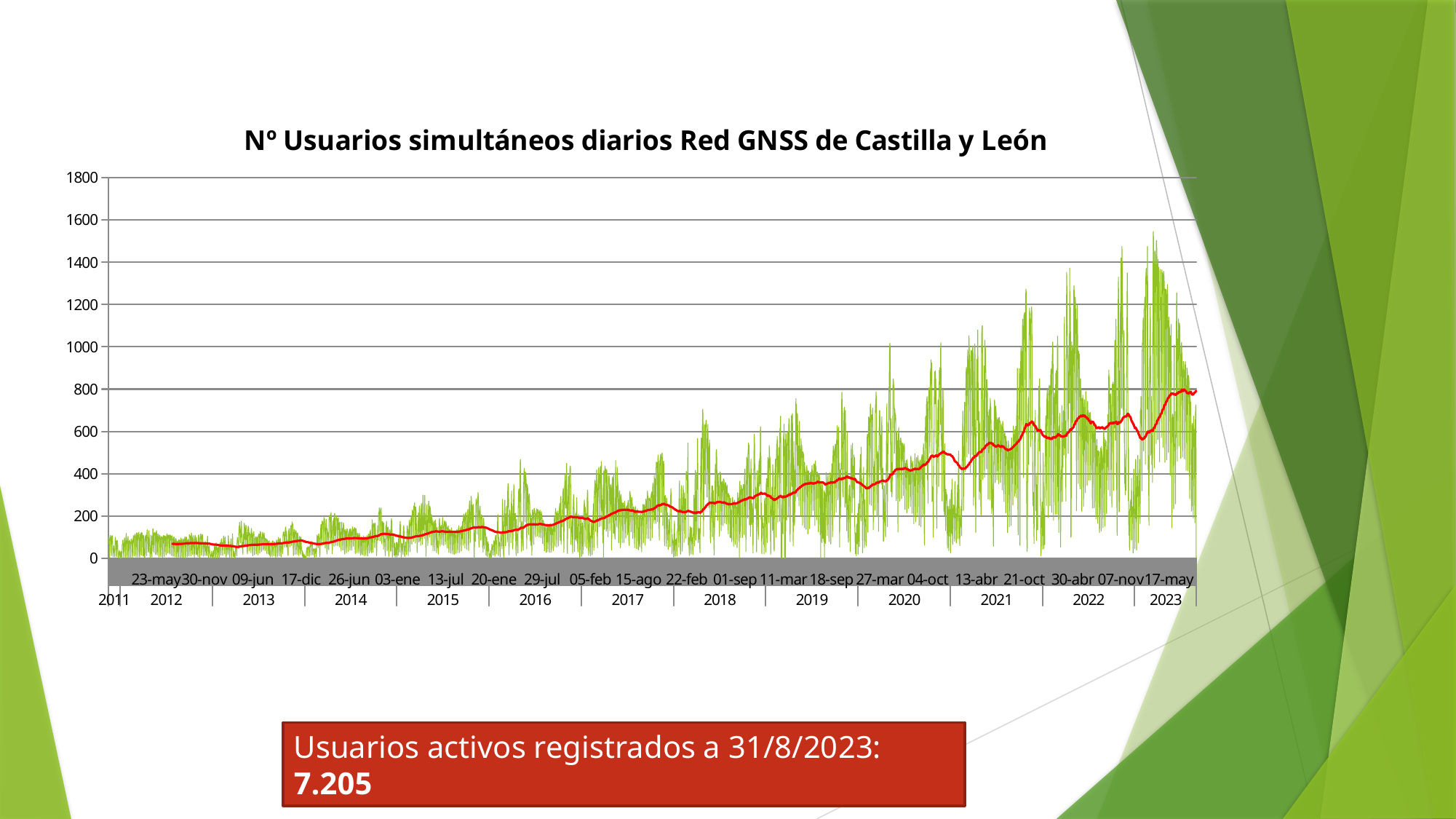
Is the value of the red smoothed line in mid-2021 greater or less than 400? greater Is the value of the red smoothed line in 2016 greater or less than 400? less Is the highest green peak in 2023 greater or less than 1400? greater What kind of chart is shown on the slide? line chart In which year does the chart reach its highest peak? 2023 What is the maximum value shown on the vertical axis? 1800 Do the values in the chart generally rise or fall from 2011 to 2023? rise What is the title of the chart? Nº Usuarios simultáneos diarios Red GNSS de Castilla y León Which year shows higher values on the chart, 2013 or 2022? 2022 How many year labels are shown along the horizontal axis? 13